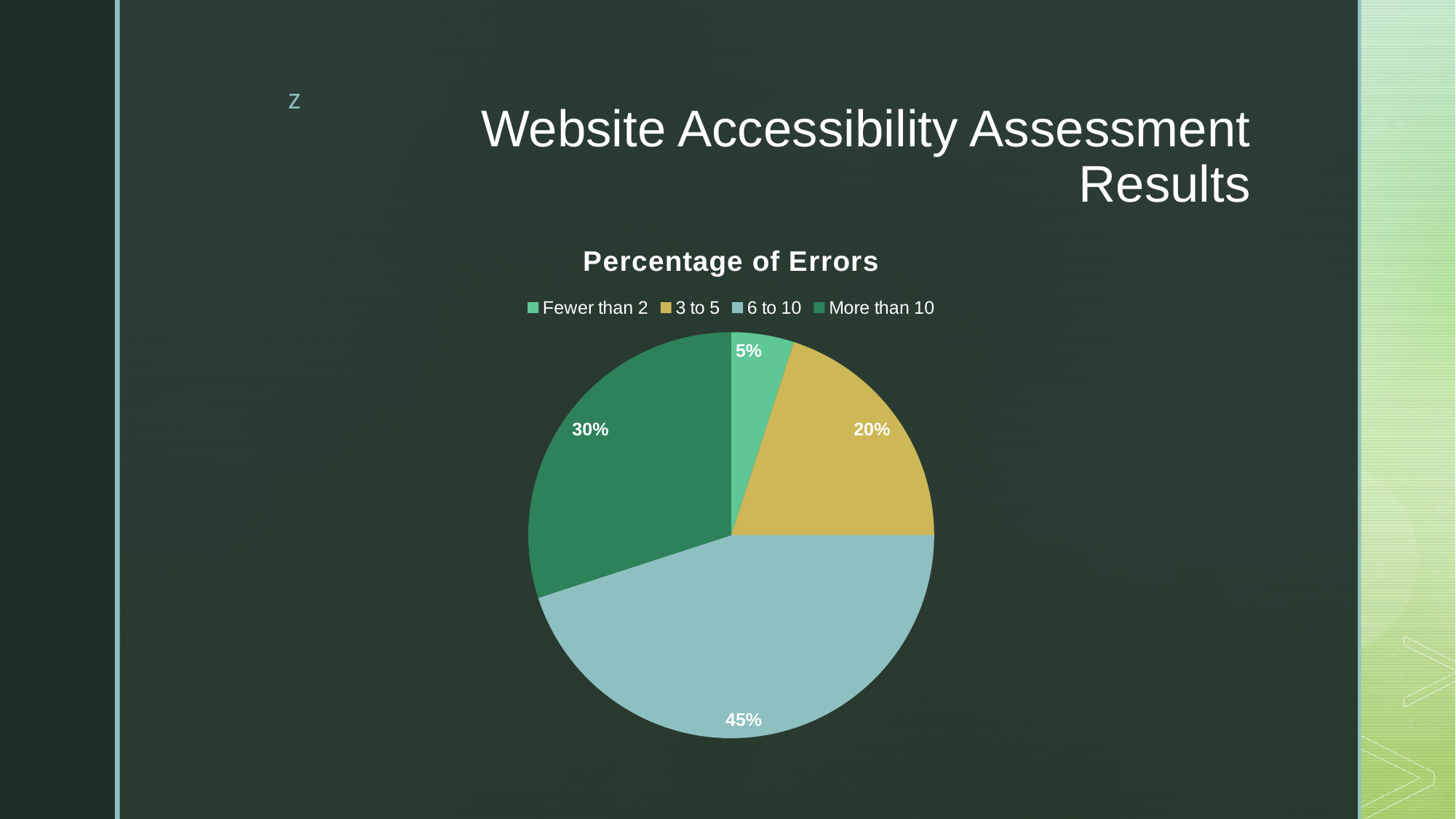
What percentage is shown for the '3 to 5' slice? 20% How many categories does the legend list? 4 What is the difference in percentage points between the '6 to 10' slice and the 'More than 10' slice? 15% What percentage is shown for the 'More than 10' slice? 30% Which category has the largest share of the pie? 6 to 10 What is the title of the chart? Percentage of Errors Which category is shown in yellow? 3 to 5 What type of chart is shown on the slide? pie chart What percentage is shown for the 'Fewer than 2' slice? 5% Which category has the smallest share of the pie? Fewer than 2 Which is larger, the '3 to 5' slice or the 'More than 10' slice? More than 10 What percentage is shown for the '6 to 10' slice? 45%